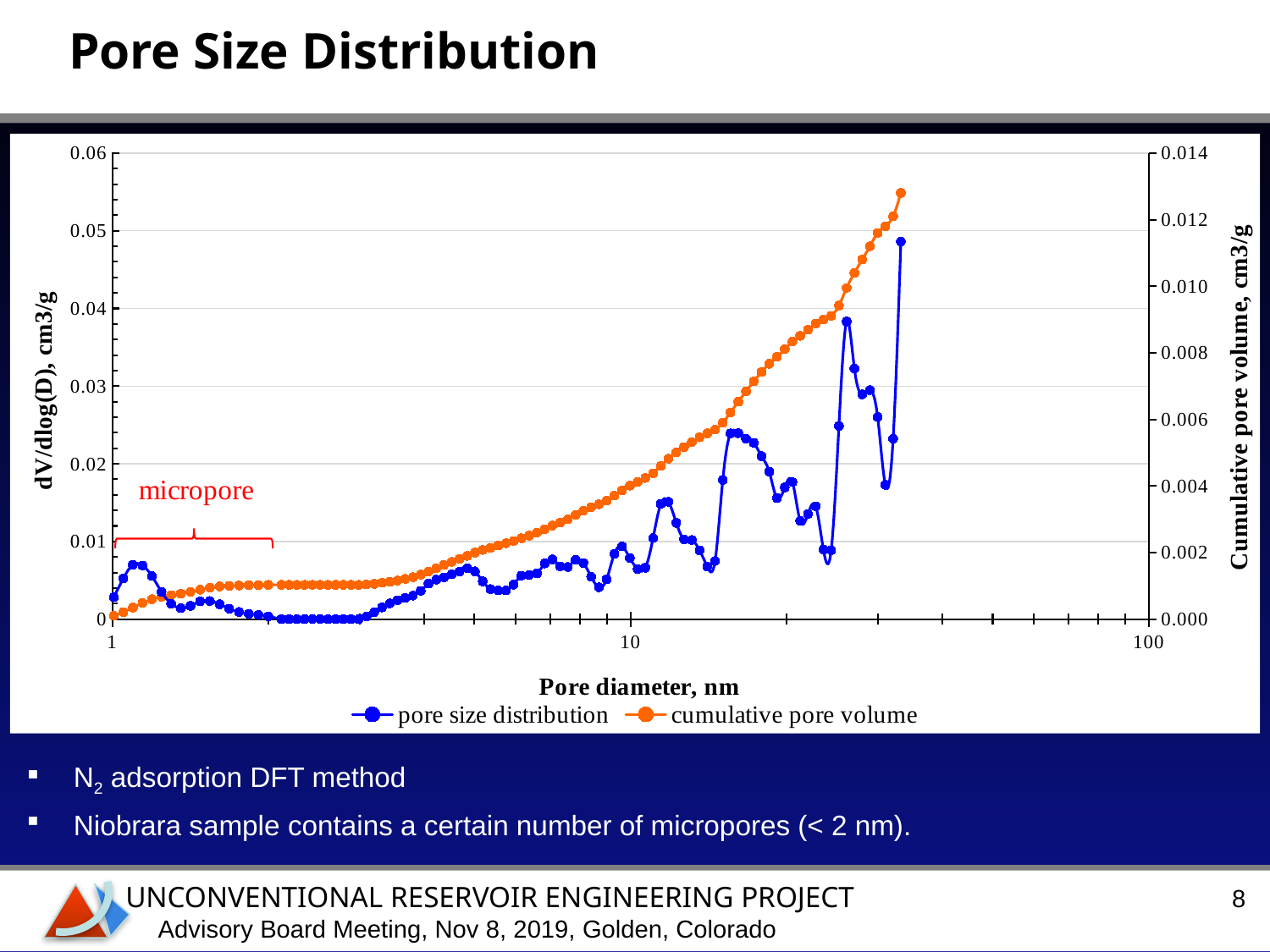
What are the two series named in the legend? pore size distribution and cumulative pore volume Does the cumulative pore volume rise or fall as pore diameter increases along the x axis? Rise Which series is plotted in orange? cumulative pore volume Is the cumulative pore volume at a pore diameter of 10 nm greater or less than 0.006? less What kind of chart is shown on the slide? Line chart Is the cumulative pore volume at the largest pore diameter plotted greater or less than 0.012? greater Is the cumulative pore volume at a pore diameter of 1 nm greater or less than 0.002? less What is the title of the x axis? Pore diameter, nm How many series does the legend list? 2